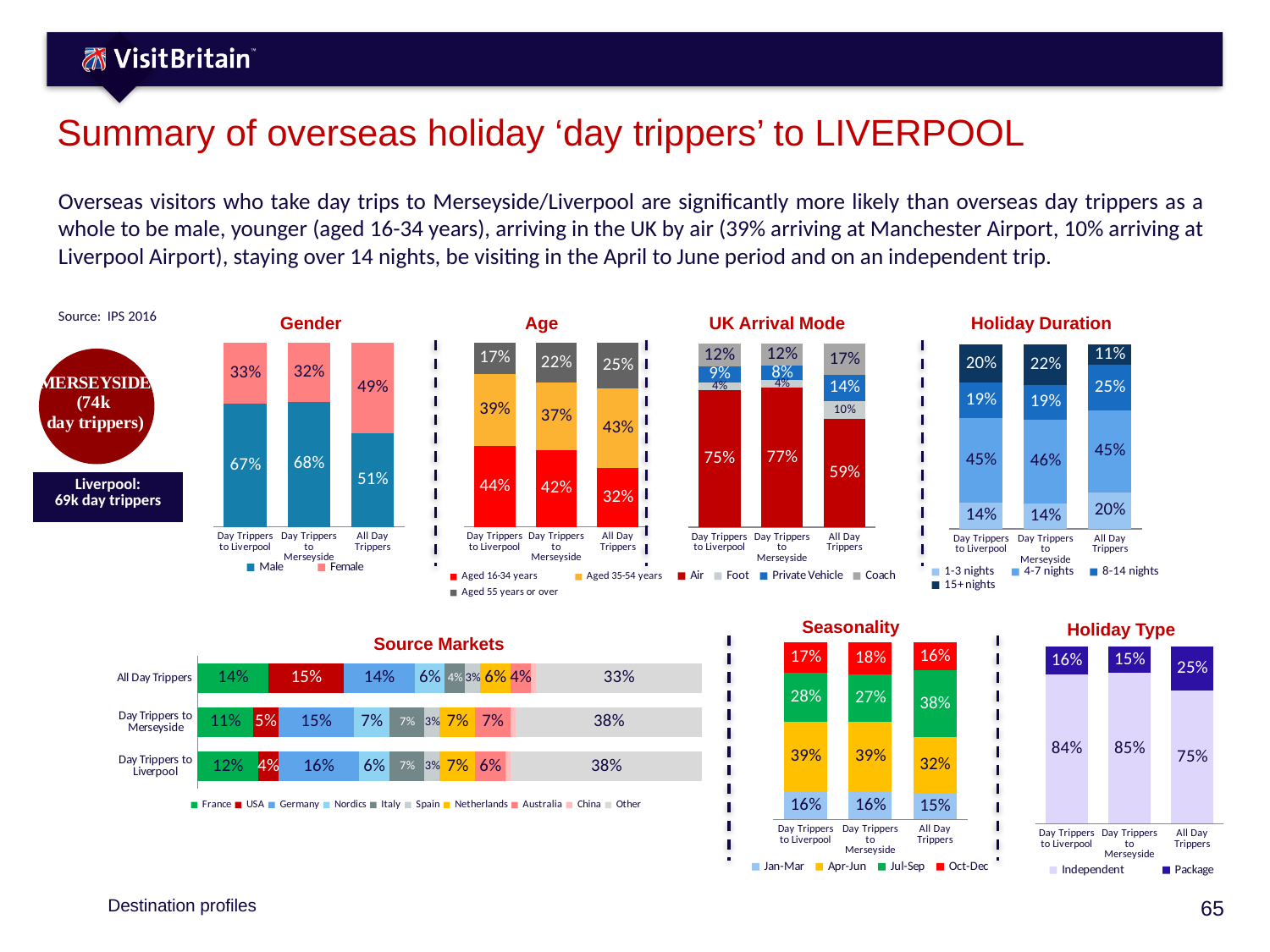
In the Source Markets chart, which is larger for All Day Trippers: the share from France or the share from USA? USA In the Source Markets chart, what percentage of Day Trippers to Liverpool come from Germany? 16% In the Seasonality chart, what percentage of All Day Trippers visit in Jul-Sep? 38% In the UK Arrival Mode chart, what percentage of Day Trippers to Merseyside arrive by air? 77% In the Seasonality chart, what is the difference between the Apr-Jun share for Day Trippers to Liverpool and for All Day Trippers? 7% In the Age chart, what share of All Day Trippers are aged 35-54 years? 43% In the Holiday Type chart, what percentage of Day Trippers to Merseyside are on an independent trip? 85% How many series does the legend of the Seasonality chart list? 4 What type of chart is the Source Markets chart? Stacked bar chart In the Holiday Duration chart, what is the difference between the 8-14 nights share for All Day Trippers and for Day Trippers to Liverpool? 6% In the Holiday Duration chart, which group has the highest share staying 15+ nights? Day Trippers to Merseyside In the Gender chart, what percentage of Day Trippers to Liverpool are male? 67%